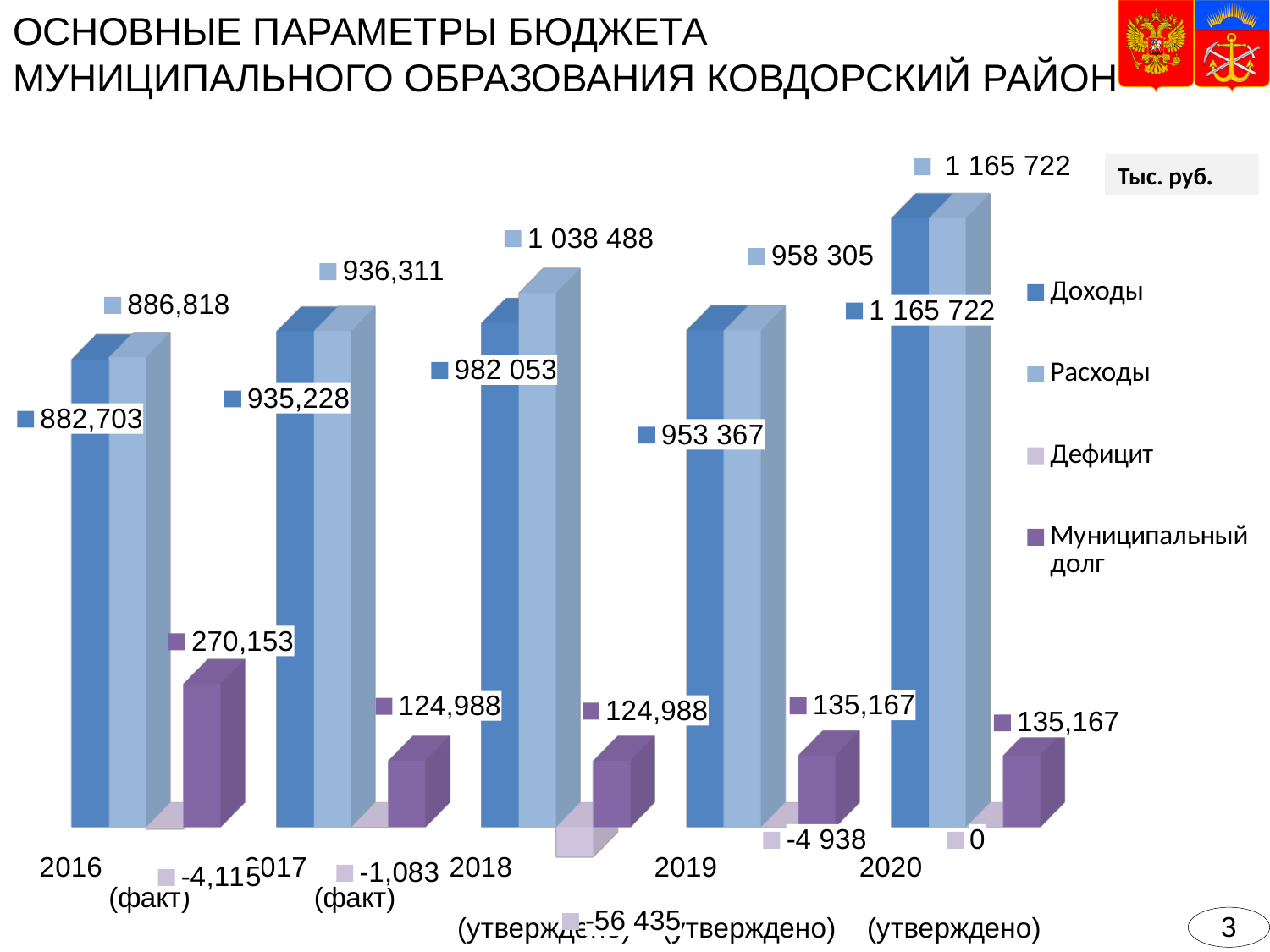
What is the value of Доходы for 2016? 882,703 In which year is Доходы the lowest? 2016 How many series does the legend list? 4 What type of chart is shown on the slide? bar chart What unit is indicated in the box at the top right of the chart? Тыс. руб. What is the value of Муниципальный долг for 2019? 135,167 What is the difference between Расходы and Доходы in 2018? 56 435 How many years (categories) are shown on the x axis? 5 What is the value of Дефицит for 2020? 0 In which year is Муниципальный долг the highest? 2016 Which is larger in 2017: Доходы or Расходы? Расходы What is the value of Расходы for 2018? 1 038 488